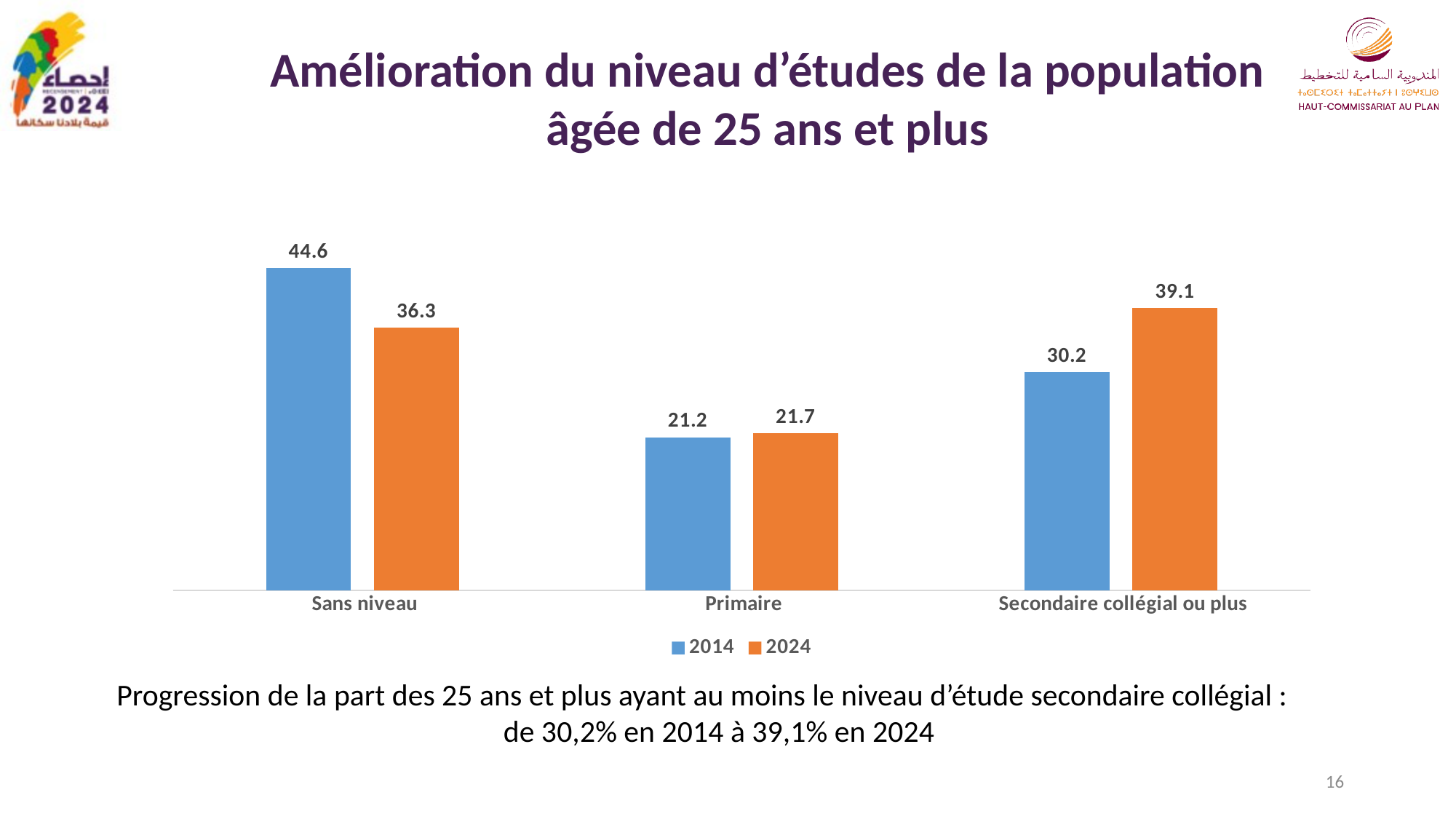
Which category has the lowest value in the 2024 series? Primaire Which colour represents the 2024 series? Orange What is the difference between the 2024 and 2014 values for Secondaire collégial ou plus? 8.9 What is the value for Sans niveau in 2014? 44.6 What kind of chart is shown on the slide? Bar chart How many series does the legend list? 2 How many categories are shown on the x axis? 3 What is the difference between the 2014 and 2024 values for Sans niveau? 8.3 Which is larger for Secondaire collégial ou plus: the 2014 value or the 2024 value? 2024 Which category has the highest value in the 2014 series? Sans niveau What is the value for Primaire in 2014? 21.2 What is the value for Secondaire collégial ou plus in 2024? 39.1